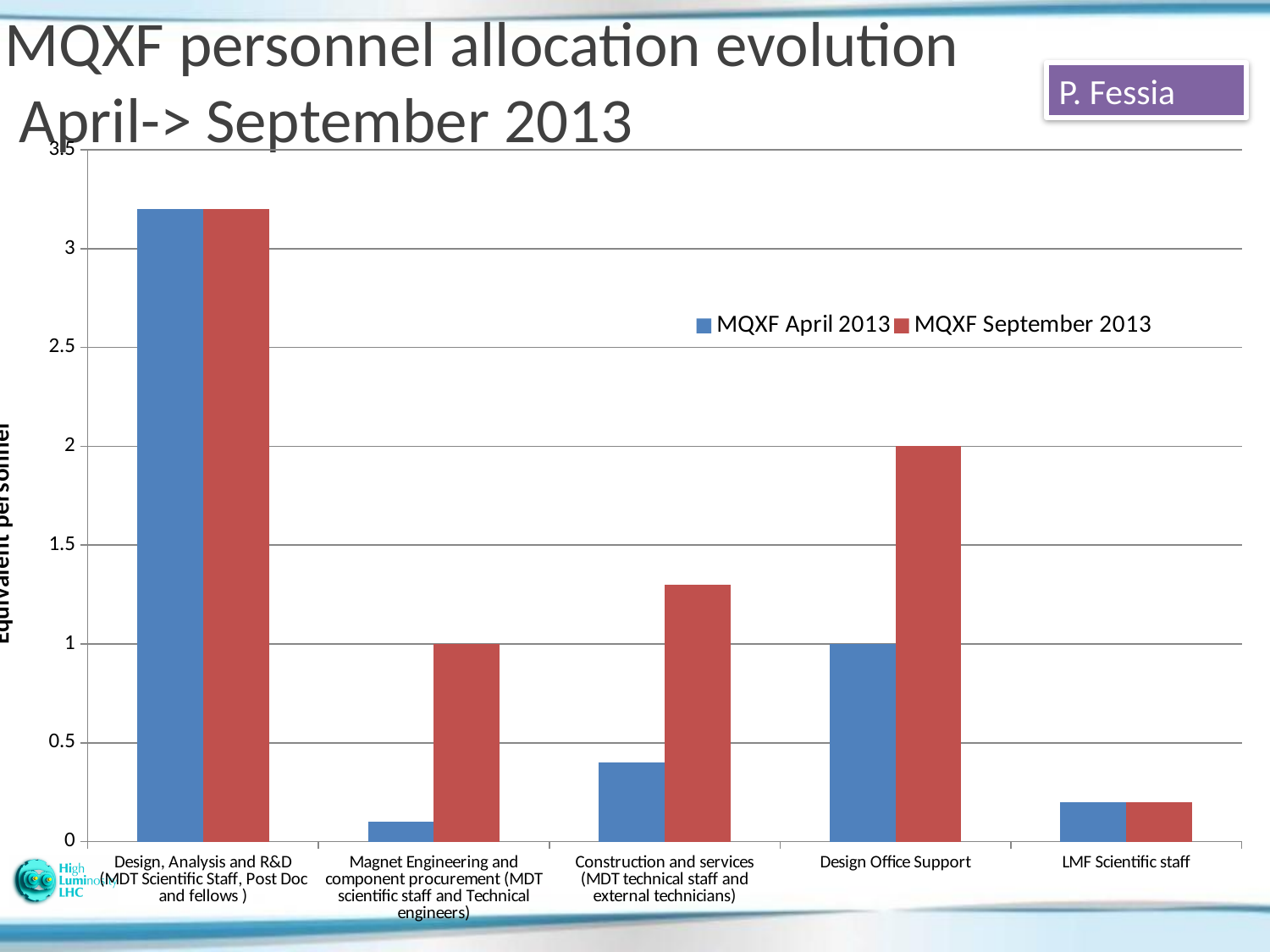
What is the difference between the MQXF September 2013 and MQXF April 2013 values for Design Office Support? 1 Is the MQXF April 2013 value for Design, Analysis and R&D greater or less than 3? greater How many categories are shown along the x axis? 5 What is the MQXF September 2013 value for Design Office Support? 2 What is the MQXF April 2013 value for Design Office Support? 1 Which category has the lowest MQXF September 2013 value? LMF Scientific staff Which series is shown in red in the legend? MQXF September 2013 How many series does the legend list? 2 Is the MQXF April 2013 value for Construction and services greater or less than 0.5? less Which category has the highest MQXF April 2013 value? Design, Analysis and R&D What is the MQXF September 2013 value for Magnet Engineering and component procurement? 1 What type of chart is shown on the slide? bar chart